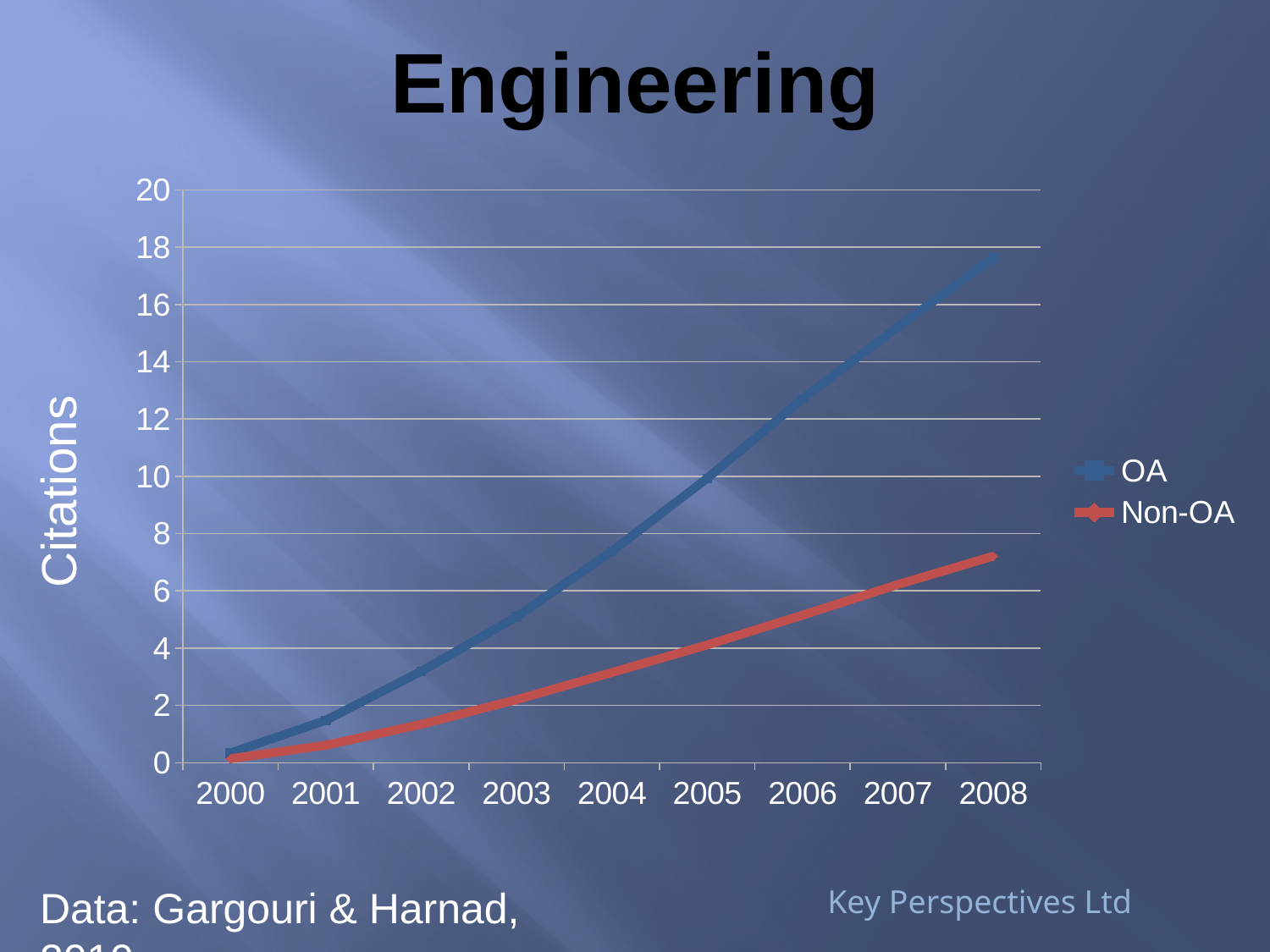
Which series has the higher value in 2008, OA or Non-OA? OA What kind of chart is shown on the slide? line chart Is the Non-OA value for 2008 greater or less than 8? less Do the OA citations rise or fall from 2000 to 2008? rise What is the label on the vertical axis? Citations In which year is the Non-OA series at its lowest? 2000 How many years are shown along the x axis? 9 Is the Non-OA value for 2004 greater or less than 4? less Is the OA value for 2008 greater or less than 16? greater How many series does the legend list? 2 In which year is the OA series at its highest? 2008 What is the title of the chart? Engineering